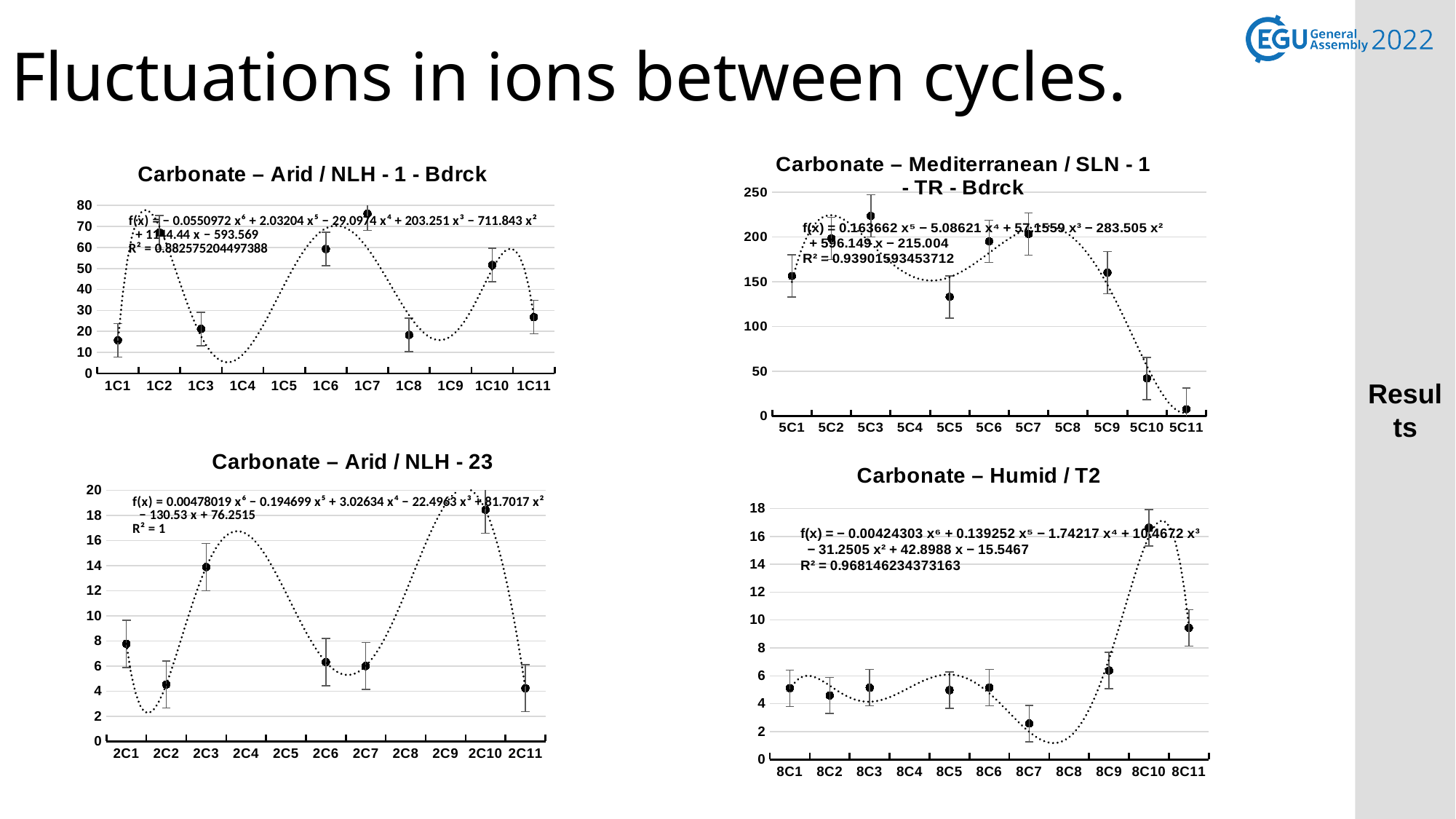
In the chart titled "Carbonate – Mediterranean / SLN - 1 - TR - Bdrck", which category has the lowest value? 5C11 In the chart titled "Carbonate – Arid / NLH - 1 - Bdrck", is the value for 1C6 greater or less than 50? greater In the chart titled "Carbonate – Arid / NLH - 1 - Bdrck", which category has the highest value? 1C7 In the chart titled "Carbonate – Mediterranean / SLN - 1 - TR - Bdrck", which category has the highest value? 5C3 In the chart titled "Carbonate – Humid / T2", which category has the lowest value? 8C7 In the chart titled "Carbonate – Humid / T2", is the value for 8C10 greater or less than 14? greater In the chart titled "Carbonate – Mediterranean / SLN - 1 - TR - Bdrck", is the value for 5C10 greater or less than 50? less In the chart titled "Carbonate – Arid / NLH - 23", which category has the highest value? 2C10 How many categories are shown on the x axis of the chart titled "Carbonate – Humid / T2"? 11 In the chart titled "Carbonate – Mediterranean / SLN - 1 - TR - Bdrck", which is larger, the value for 5C3 or the value for 5C5? 5C3